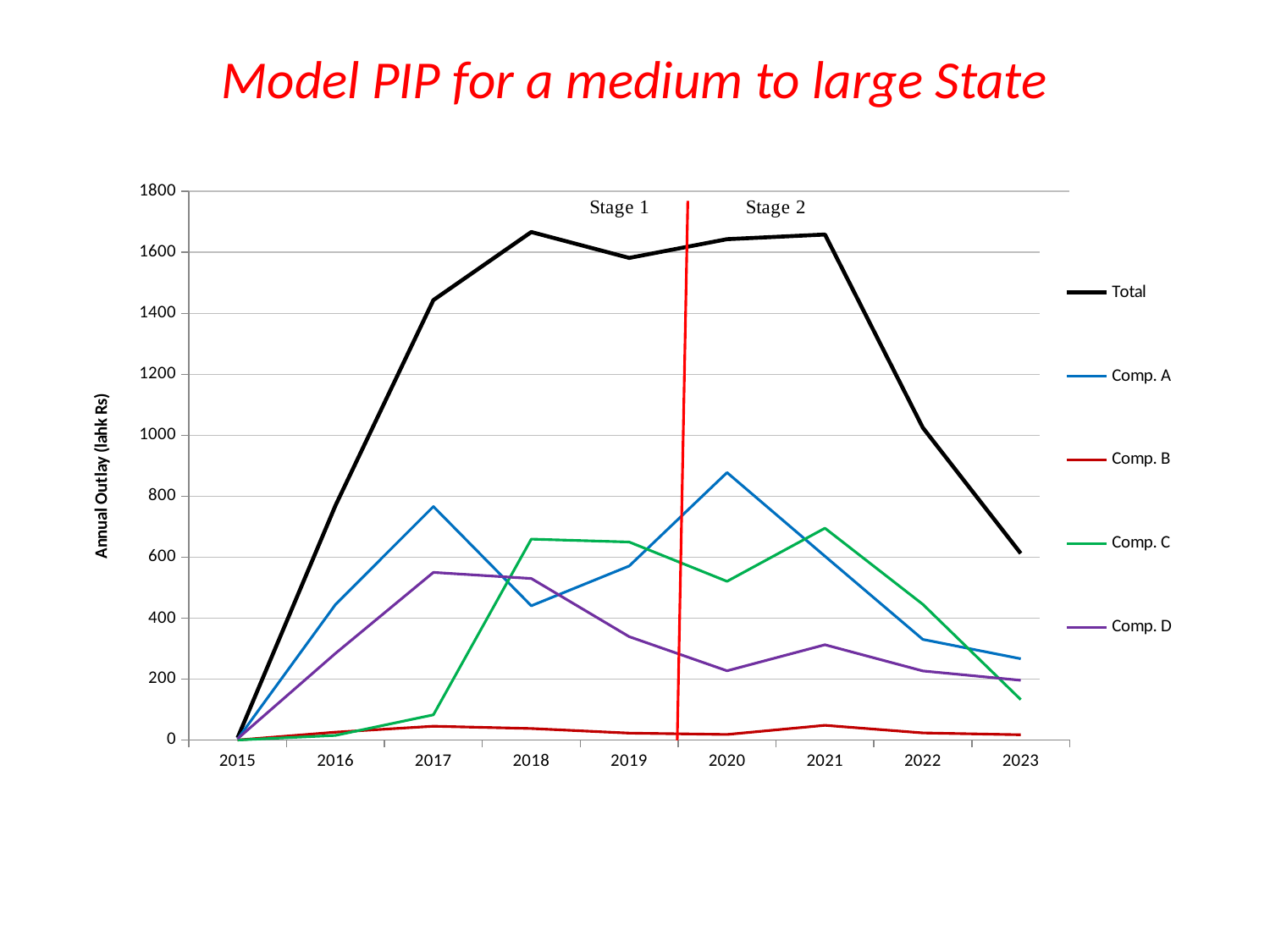
Does the Total line rise or fall from 2021 to 2023? fall How many series does the legend list? 5 How many years are shown on the x axis? 9 Which series has the lowest value in 2021? Comp. B Is the value of Comp. D in 2020 greater or less than 400? less Is the value of Total in 2018 greater or less than 1600? greater What kind of chart is shown on the slide? line chart Is the value of Total in 2023 greater or less than 800? less Which is larger in 2018, Comp. A or Comp. C? Comp. C In which year does Comp. A reach its highest value? 2020 What is the label on the y axis? Annual Outlay (lahk Rs) Among the four components (Comp. A to Comp. D), which has the highest value in 2020? Comp. A